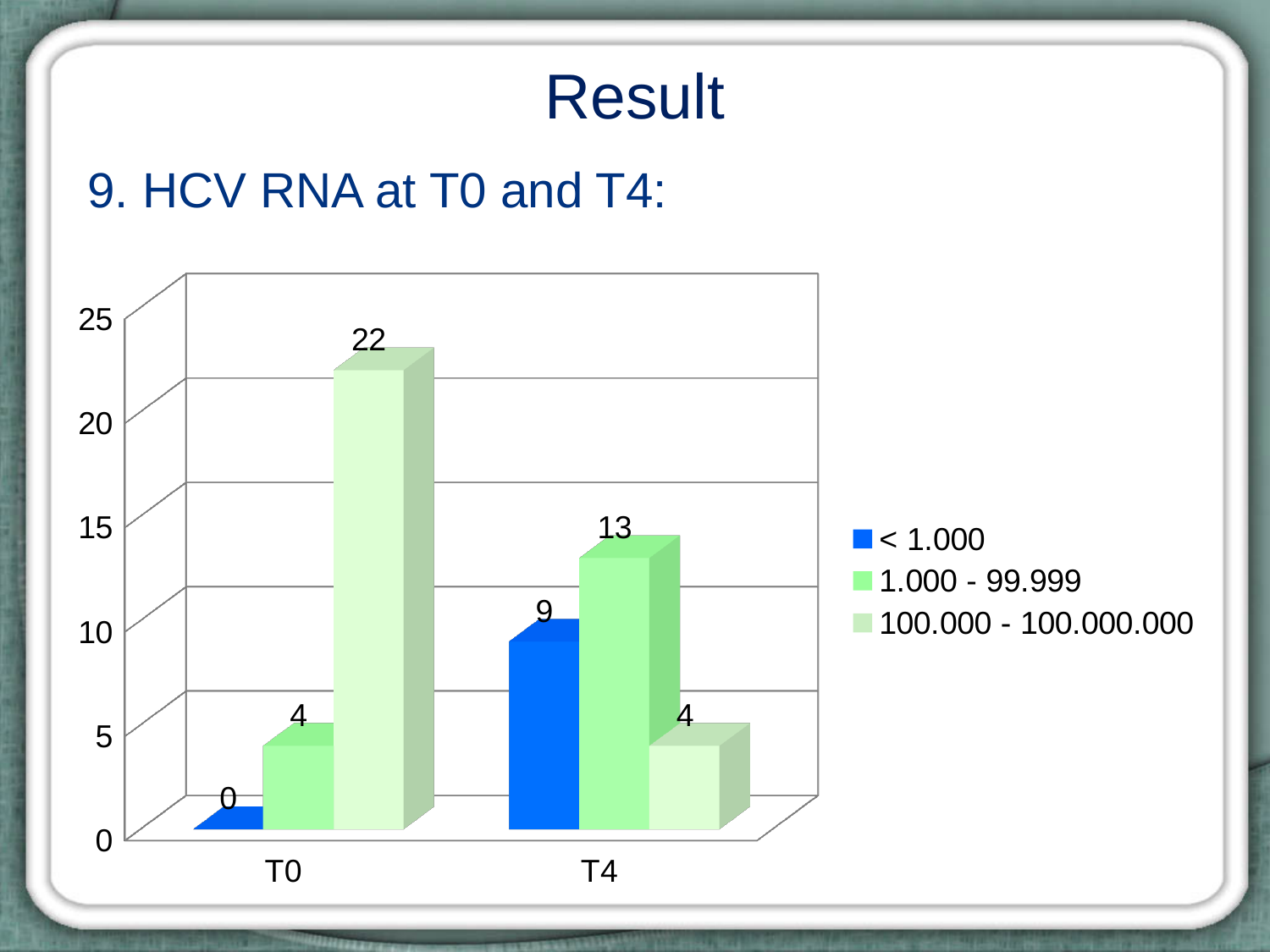
How many categories are shown on the x axis? 2 What is the difference between the '100.000 - 100.000.000' values at T0 and T4? 18 What kind of chart is shown on the slide? bar chart What is the value for the '< 1.000' series at T4? 9 What is the value for the '100.000 - 100.000.000' series at T0? 22 Which series has the lowest value at T4? 100.000 - 100.000.000 What is the value for the '< 1.000' series at T0? 0 Which series has the highest value at T0? 100.000 - 100.000.000 What is the value for the '1.000 - 99.999' series at T4? 13 Which is larger: the '1.000 - 99.999' value at T0 or at T4? T4 How many series does the legend list? 3 What is the total of the three values at T4? 26